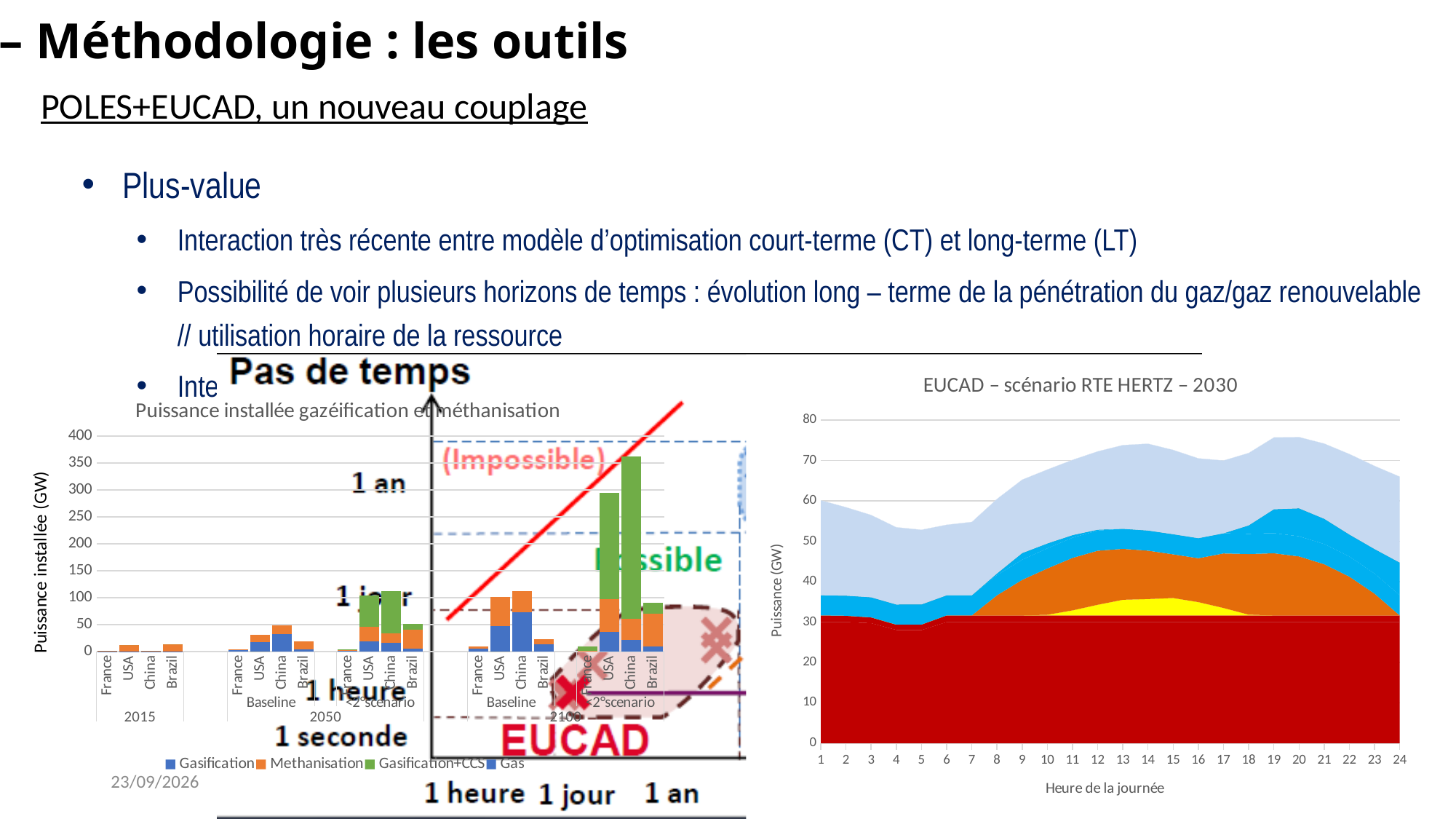
In the chart "Puissance installée gazéification et méthanisation", is the total bar for USA in the 2100 <2°scenario greater or less than 200? greater In the chart "EUCAD – scénario RTE HERTZ – 2030", how many hours are shown on the x axis? 24 In the chart "Puissance installée gazéification et méthanisation", how many countries are shown in each scenario group? 4 In the chart "Puissance installée gazéification et méthanisation", which is larger in the 2100 <2°scenario: the total bar for China or the total bar for USA? China In the chart "Puissance installée gazéification et méthanisation", is the total bar for China in the 2100 <2°scenario greater or less than 300? greater What type of chart is the chart titled "Puissance installée gazéification et méthanisation"? bar chart In the chart "Puissance installée gazéification et méthanisation", which country has the tallest bar in the 2100 <2°scenario group? China In the chart "EUCAD – scénario RTE HERTZ – 2030", is the top of the stacked area at hour 20 greater or less than 70? greater In the chart "Puissance installée gazéification et méthanisation", how many series does the legend list? 4 In the chart "EUCAD – scénario RTE HERTZ – 2030", does the top of the stacked area rise or fall from hour 7 to hour 12? rise What type of chart is the chart titled "EUCAD – scénario RTE HERTZ – 2030"? area chart